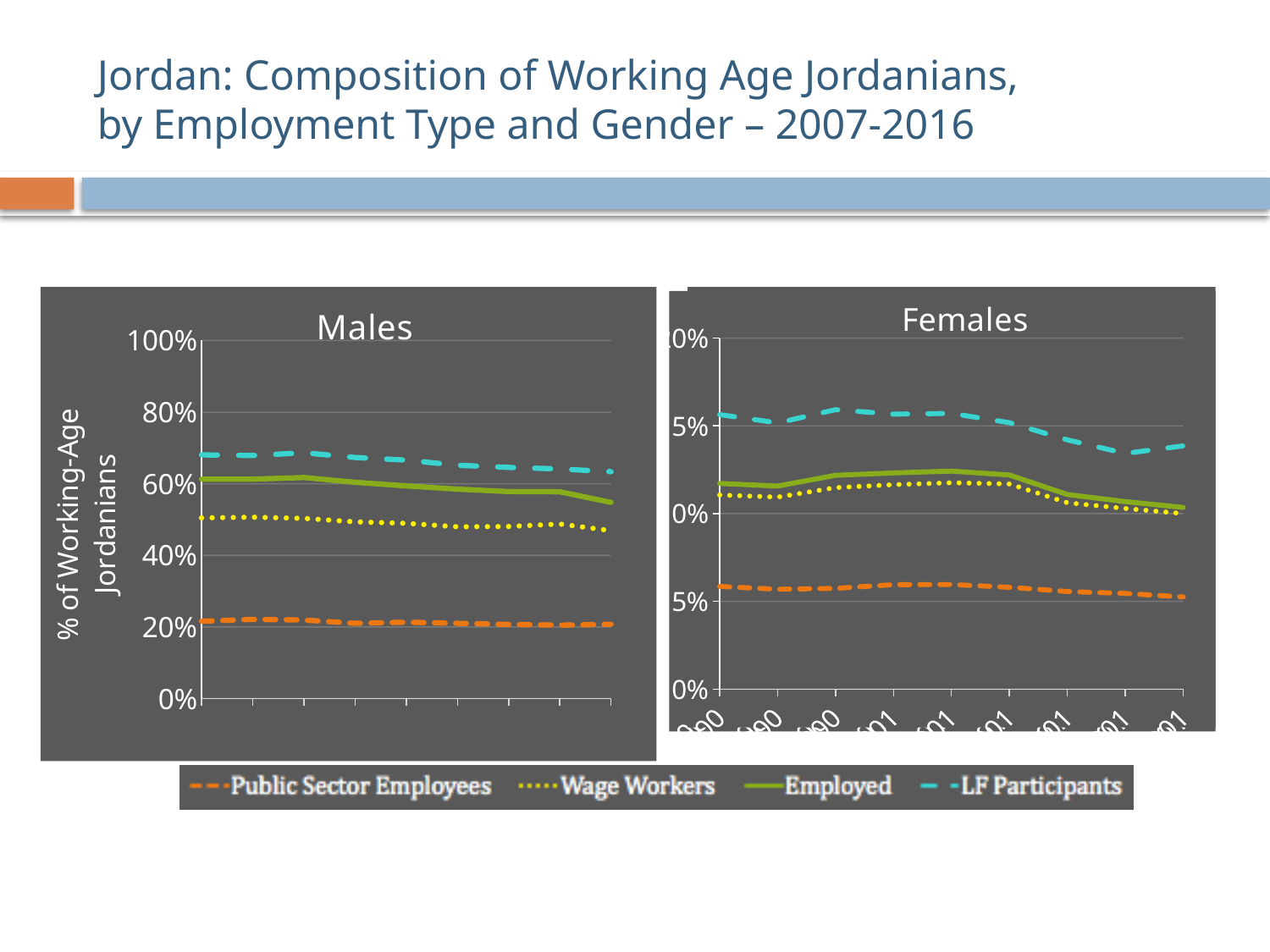
In the Males chart, which series has the lowest values? Public Sector Employees What kind of chart is the Males chart? line chart In the Males chart, which is larger, Employed or Wage Workers? Employed In the Males chart, which series has the highest values? LF Participants In the Males chart, is the value for Public Sector Employees greater or less than 40%? less In the Females chart, which series has the lowest values? Public Sector Employees How many series does the legend list? 4 In the Males chart, is the value for Wage Workers greater or less than 60%? less What is the y-axis label of the Males chart? % of Working-Age Jordanians In the Males chart, is the value for LF Participants greater or less than 60%? greater In the Males chart, do the values for LF Participants rise or fall along the x axis? fall In the Females chart, which is larger, LF Participants or Public Sector Employees? LF Participants